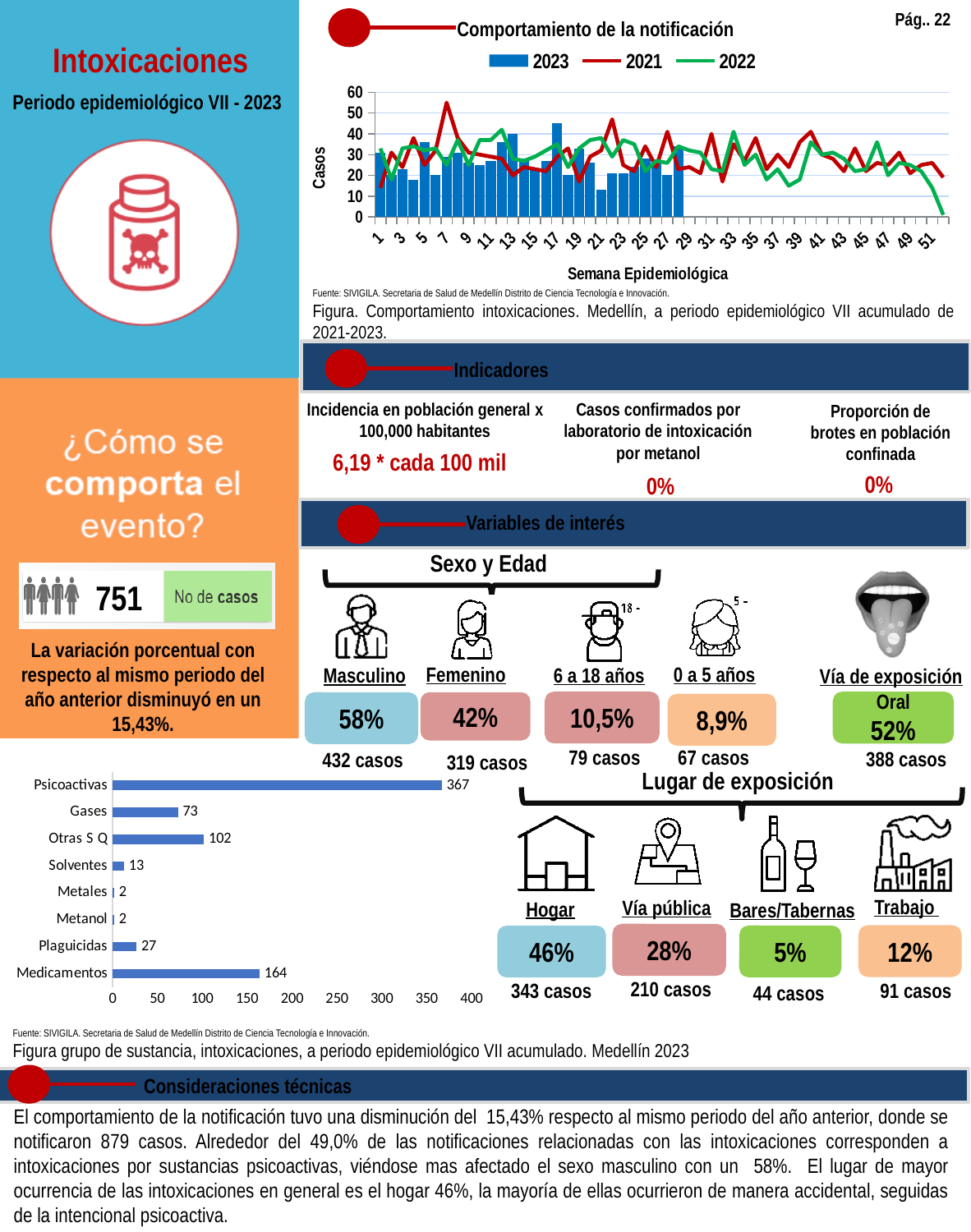
In the bar chart at the bottom left (grupo de sustancia), what is the difference between Otras S Q and Gases? 29 In the bar chart at the bottom left (grupo de sustancia), what is the value for Psicoactivas? 367 What is the x-axis label of the 'Comportamiento de la notificación' chart? Semana Epidemiológica In the 'Comportamiento de la notificación' chart, is the 2021 value at week 7 greater or less than 50? greater In the bar chart at the bottom left (grupo de sustancia), what is the value for Medicamentos? 164 In the 'Comportamiento de la notificación' chart, is the 2023 value at week 17 greater or less than 40? greater How many series does the legend of the 'Comportamiento de la notificación' chart list? 3 In the bar chart at the bottom left (grupo de sustancia), which category has the highest value? Psicoactivas In the bar chart at the bottom left (grupo de sustancia), what is the value for Plaguicidas? 27 How many categories are shown in the bar chart at the bottom left (grupo de sustancia)? 8 What kind of chart is the one at the bottom left showing substance groups? Bar chart In the bar chart at the bottom left (grupo de sustancia), which is larger, Solventes or Plaguicidas? Plaguicidas